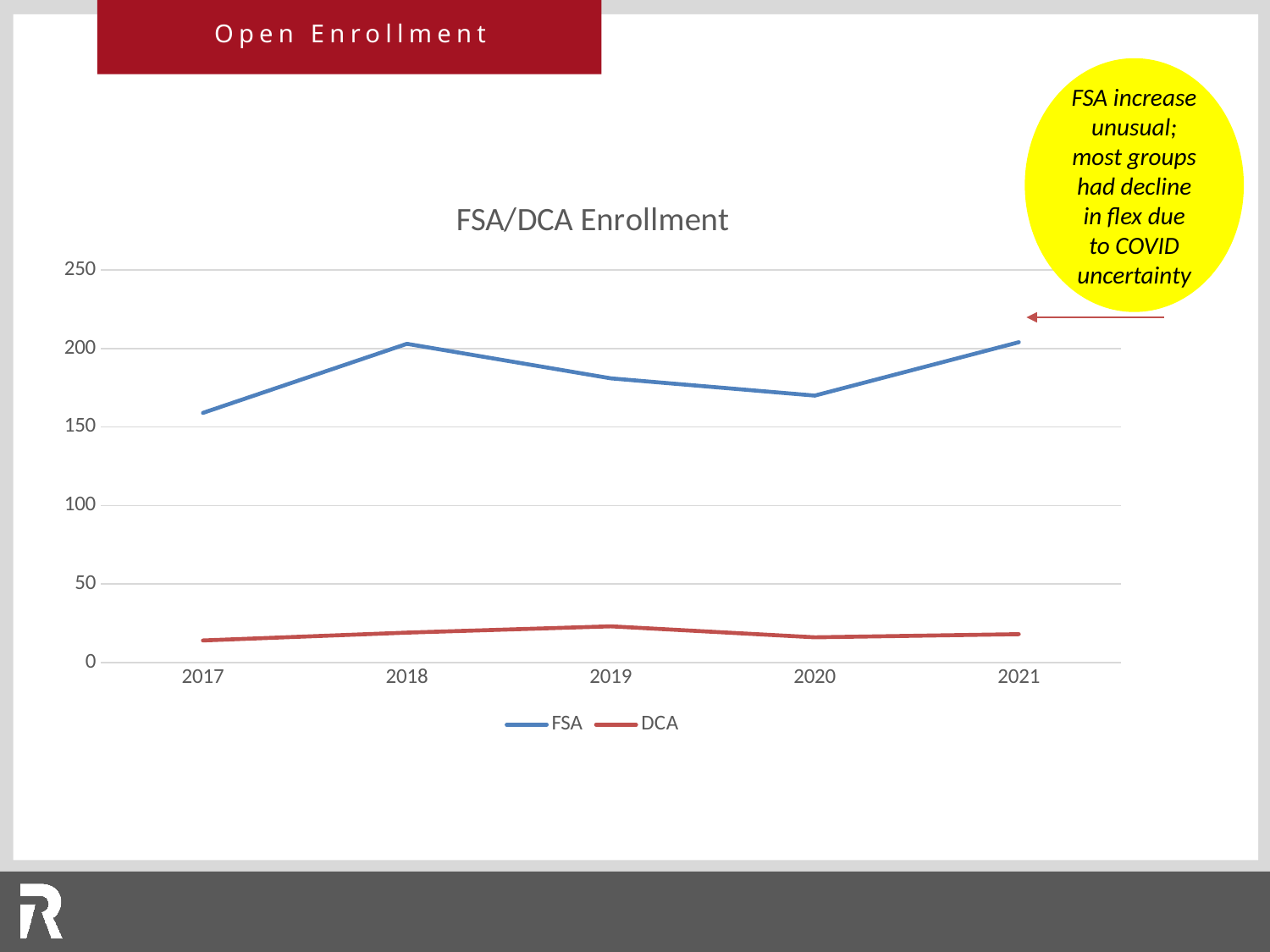
Is the DCA value for 2019 greater or less than 50? less What kind of chart is shown on the slide? line chart Which colour is the FSA line? blue Which series has the larger value in 2019, FSA or DCA? FSA How many years are plotted along the x axis? 5 In which year is the FSA value lowest? 2017 What is the title of the chart? FSA/DCA Enrollment Does the FSA line rise or fall from 2018 to 2020? fall Is the FSA value for 2017 greater or less than 150? greater Is the FSA value for 2019 greater or less than 200? less How many series does the legend list? 2